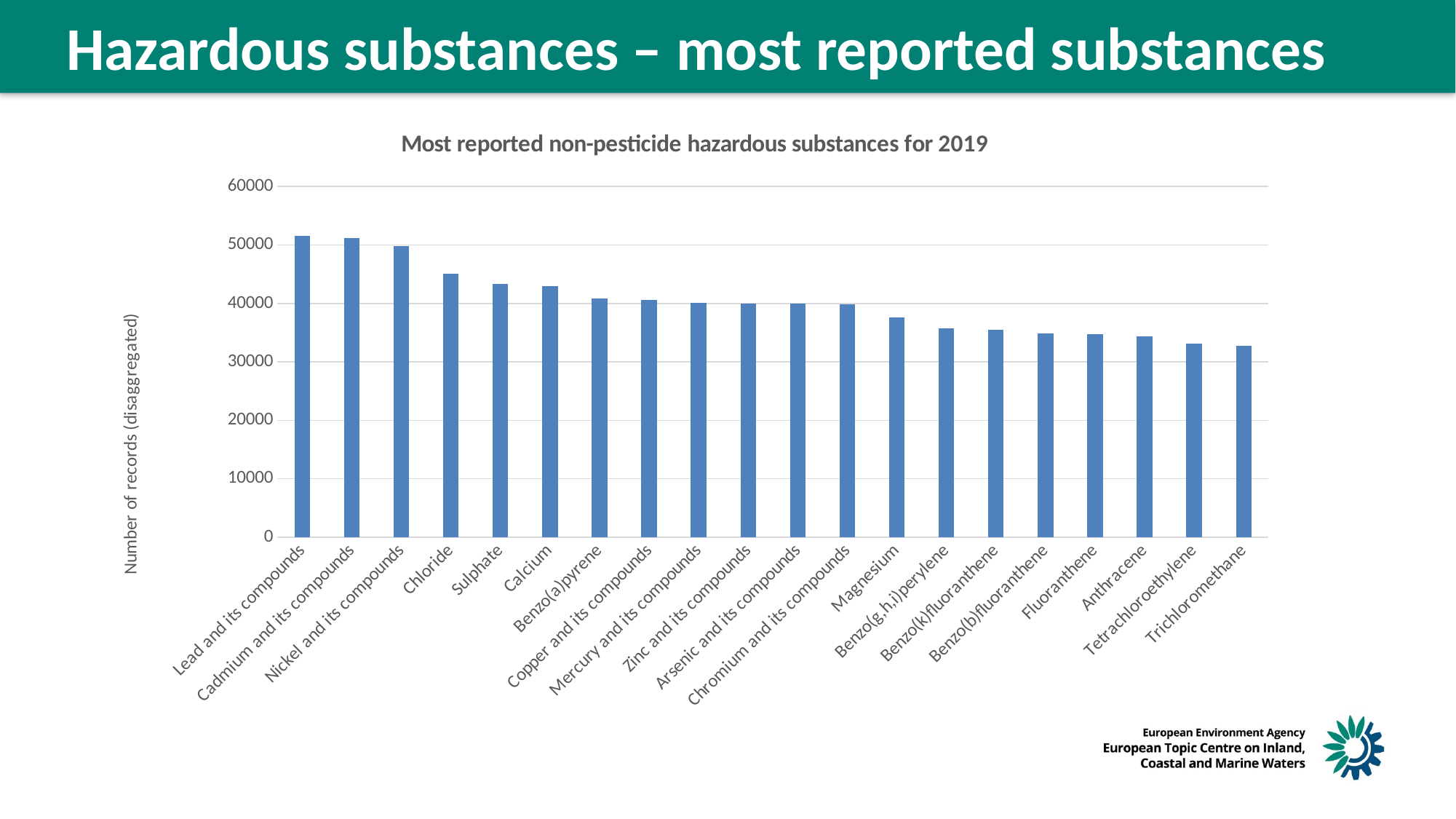
Do the values rise or fall from left to right along the x axis? fall What is the label on the vertical axis of the chart? Number of records (disaggregated) Is the value for Lead and its compounds greater or less than 50000? greater Which has a higher value, Nickel and its compounds or Trichloromethane? Nickel and its compounds Is the value for Anthracene greater or less than 40000? less How many substances are plotted on the chart? 20 Is the value for Chloride greater or less than 40000? greater Which has a higher value, Chloride or Magnesium? Chloride What kind of chart is shown on the slide? bar chart What is the title of the chart? Most reported non-pesticide hazardous substances for 2019